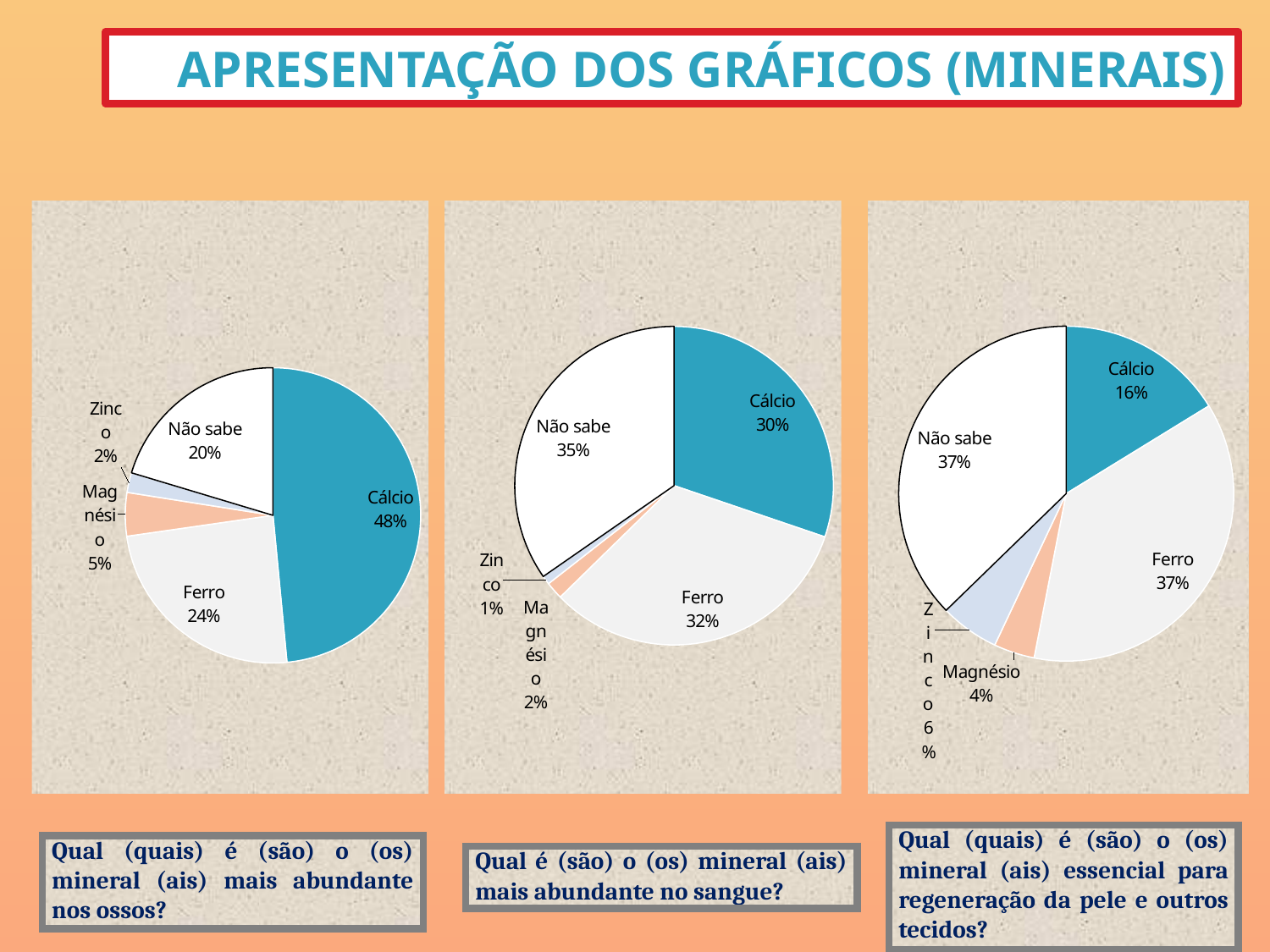
In the middle pie chart, which category has the largest slice? Não sabe In the right pie chart, what is the difference between the Ferro and Cálcio shares? 21% What kind of chart is the left chart on the slide? pie chart In the left pie chart, what is the difference between the Ferro and Não sabe shares? 4% In the left pie chart, what is the share for Cálcio? 48% In the left pie chart, which category has the smallest slice? Zinco In the right pie chart, what is the share for Ferro? 37% In the middle pie chart, what is the share for Zinco? 1% How many slices does the left pie chart have? 5 In the right pie chart, which is larger, Zinco or Magnésio? Zinco In the right pie chart, which category has the smallest slice? Magnésio In the middle pie chart, what is the share for Não sabe? 35%